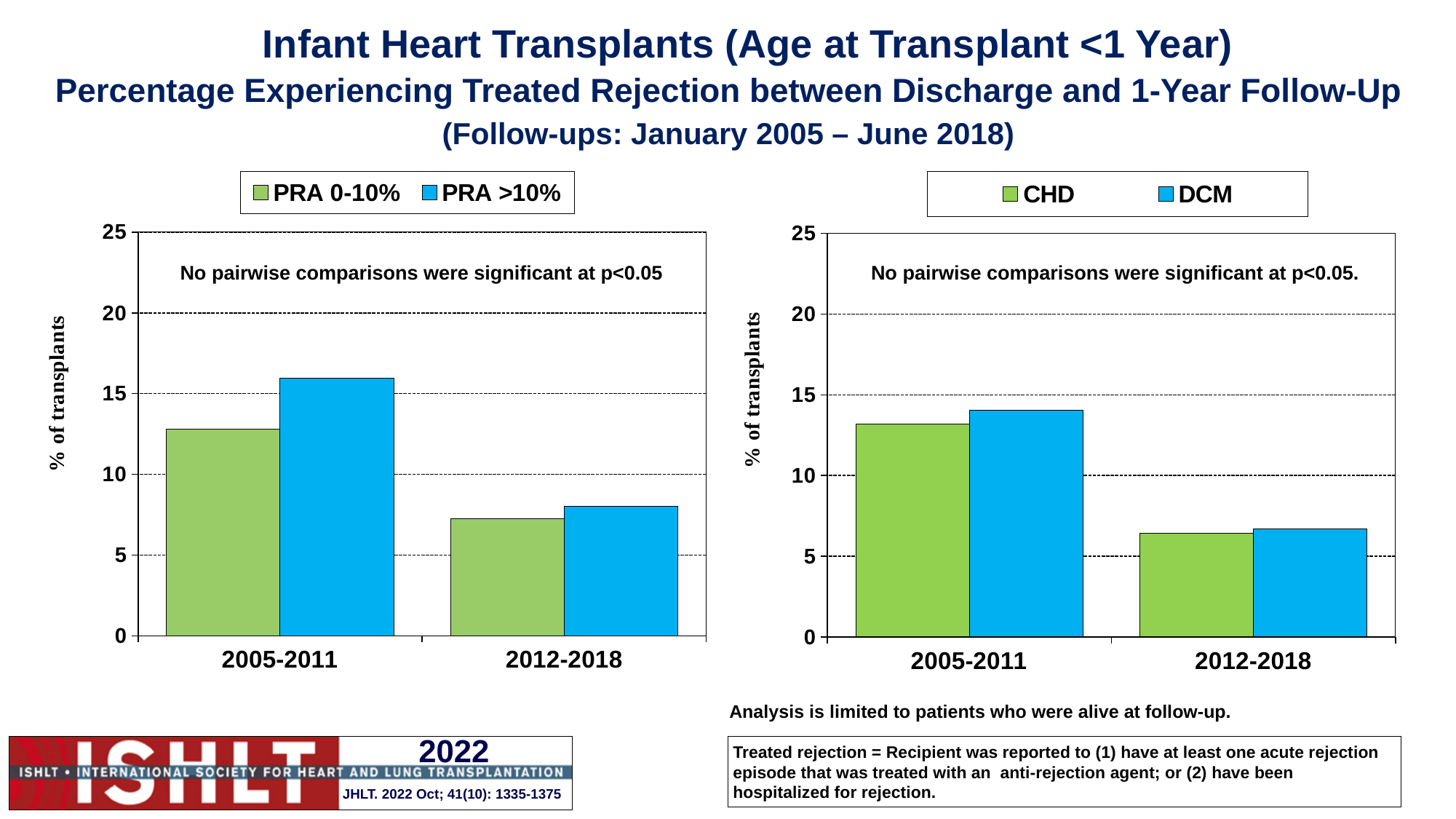
In the left chart (PRA 0-10% vs PRA >10%), is the value for PRA 0-10% in 2012-2018 greater or less than 10? less In the right chart (CHD vs DCM), do the CHD values rise or fall from 2005-2011 to 2012-2018? fall In the right chart (CHD vs DCM), is the value for CHD in 2005-2011 greater or less than 10? greater In the left chart (PRA 0-10% vs PRA >10%), which series has the larger value in 2005-2011? PRA >10% In the left chart (PRA 0-10% vs PRA >10%), what kind of chart is shown? bar chart In the left chart (PRA 0-10% vs PRA >10%), how many series does the legend list? 2 In the right chart (CHD vs DCM), is the value for DCM in 2012-2018 greater or less than 10? less In the right chart (CHD vs DCM), how many categories are shown on the x axis? 2 In the left chart (PRA 0-10% vs PRA >10%), which bar is the lowest overall? PRA 0-10% in 2012-2018 In the left chart (PRA 0-10% vs PRA >10%), which bar is the highest overall? PRA >10% in 2005-2011 In the right chart (CHD vs DCM), what colour are the DCM bars? blue